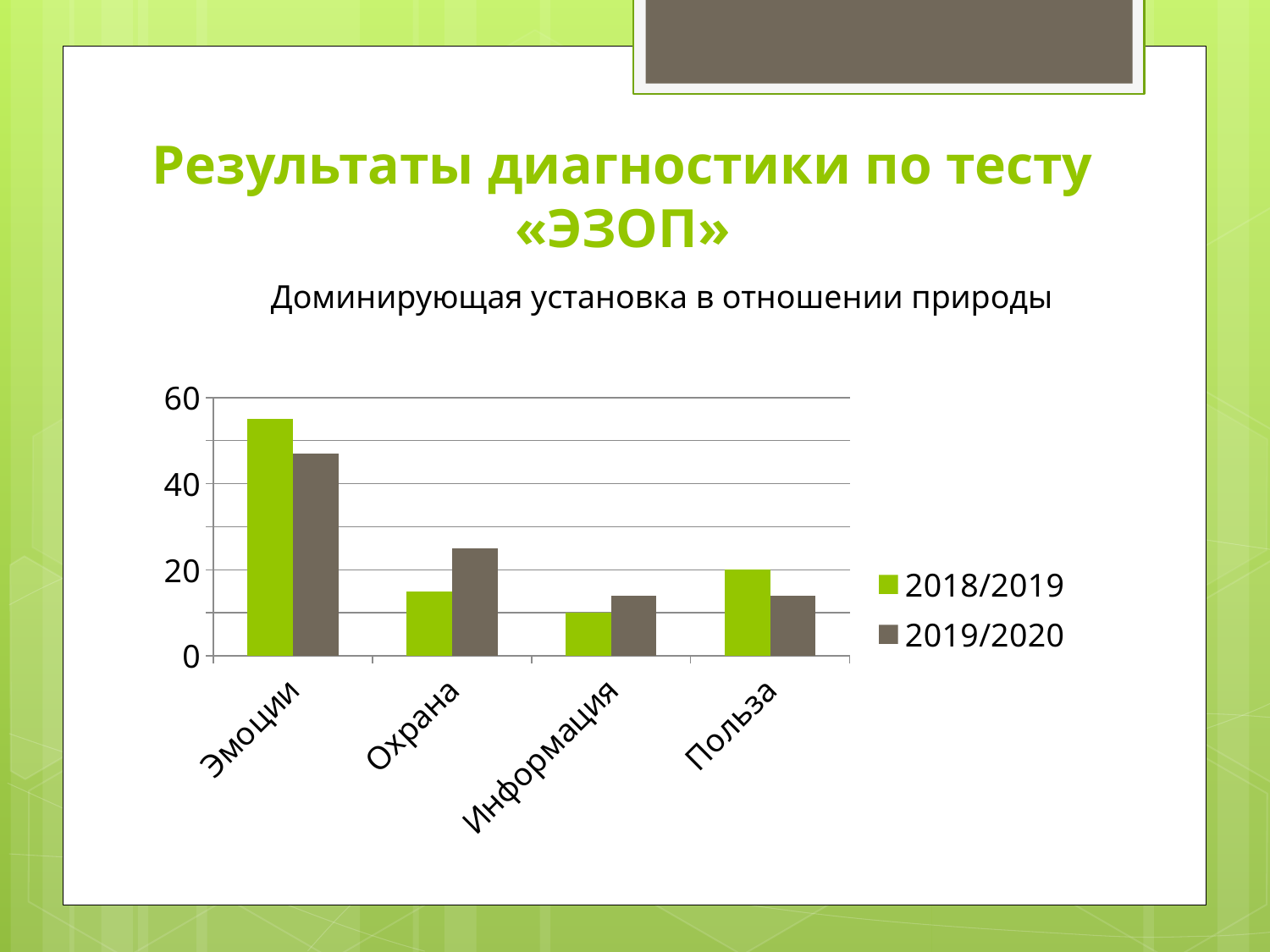
Is the value for Эмоции in the 2018/2019 series greater or less than 40? greater Is the value for Охрана in the 2019/2020 series greater or less than 20? greater How many series does the chart legend list? 2 Which category has the lowest value for the 2018/2019 series? Информация For Польза, which series has the larger value, 2018/2019 or 2019/2020? 2018/2019 Which category has the highest value for the 2018/2019 series? Эмоции Is the value for Информация in the 2018/2019 series greater or less than 20? less How many categories are shown on the x axis of the chart? 4 For Охрана, which series has the larger value, 2018/2019 or 2019/2020? 2019/2020 What is the title shown above the chart? Доминирующая установка в отношении природы Which category has the highest value for the 2019/2020 series? Эмоции What kind of chart is shown on the slide? bar chart